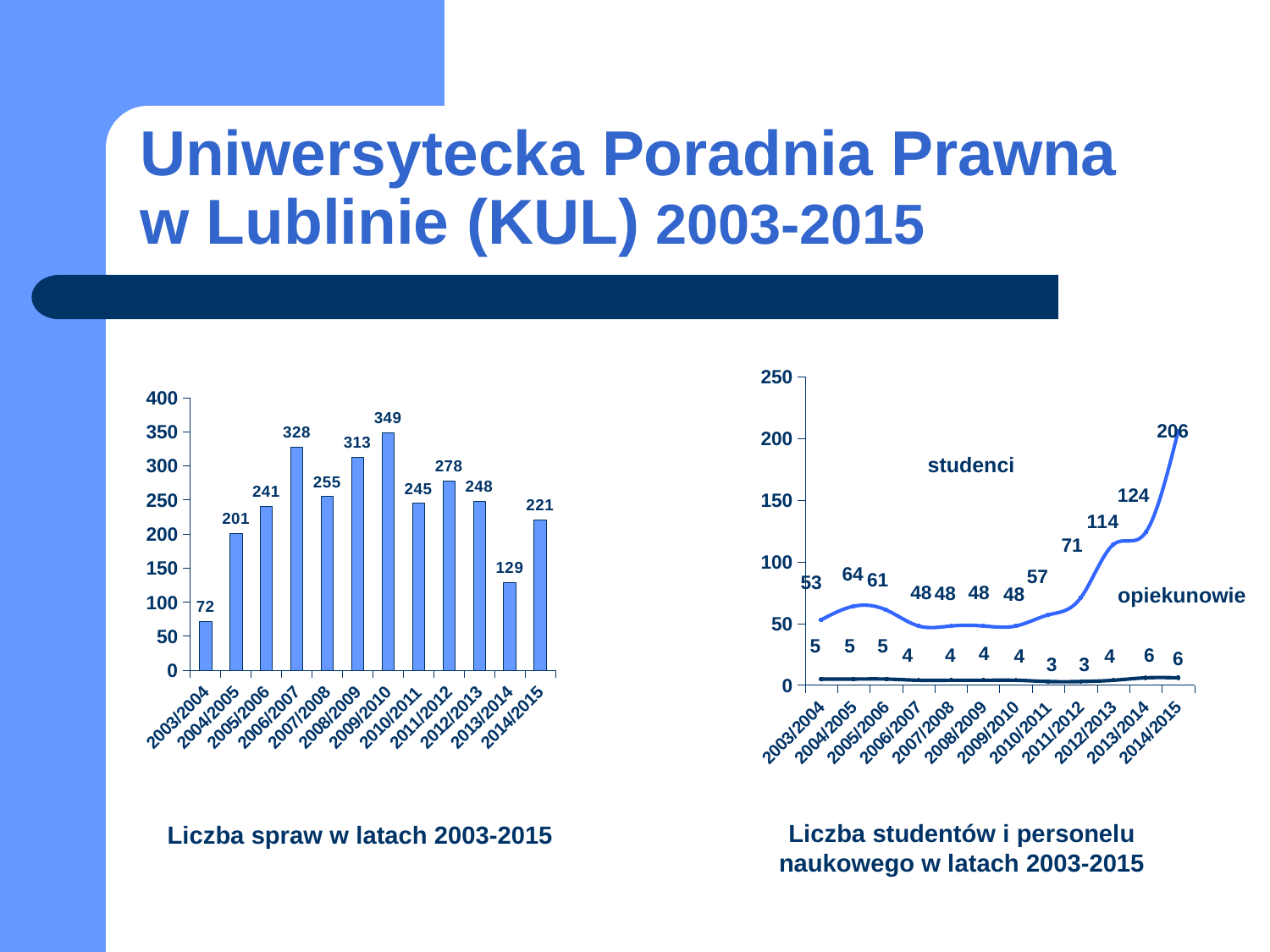
In the left chart (Liczba spraw w latach 2003-2015), how many years are shown on the x axis? 12 In the left chart (Liczba spraw w latach 2003-2015), what is the difference between the values for 2009/2010 and 2013/2014? 220 In the left chart (Liczba spraw w latach 2003-2015), which is larger, the value for 2011/2012 or the value for 2012/2013? 2011/2012 In the right chart (Liczba studentów i personelu naukowego), what is the difference between studenci and opiekunowie in 2013/2014? 118 What kind of chart is the left chart (Liczba spraw w latach 2003-2015)? bar chart What kind of chart is the right chart (Liczba studentów i personelu naukowego)? line chart In the right chart (Liczba studentów i personelu naukowego), what is the value for opiekunowie in 2010/2011? 3 In the left chart (Liczba spraw w latach 2003-2015), which year has the highest value? 2009/2010 In the left chart (Liczba spraw w latach 2003-2015), what is the value for 2006/2007? 328 In the right chart (Liczba studentów i personelu naukowego), does the studenci line rise or fall from 2011/2012 to 2014/2015? rise In the left chart (Liczba spraw w latach 2003-2015), which year has the lowest value? 2003/2004 In the right chart (Liczba studentów i personelu naukowego), what is the value for studenci in 2014/2015? 206